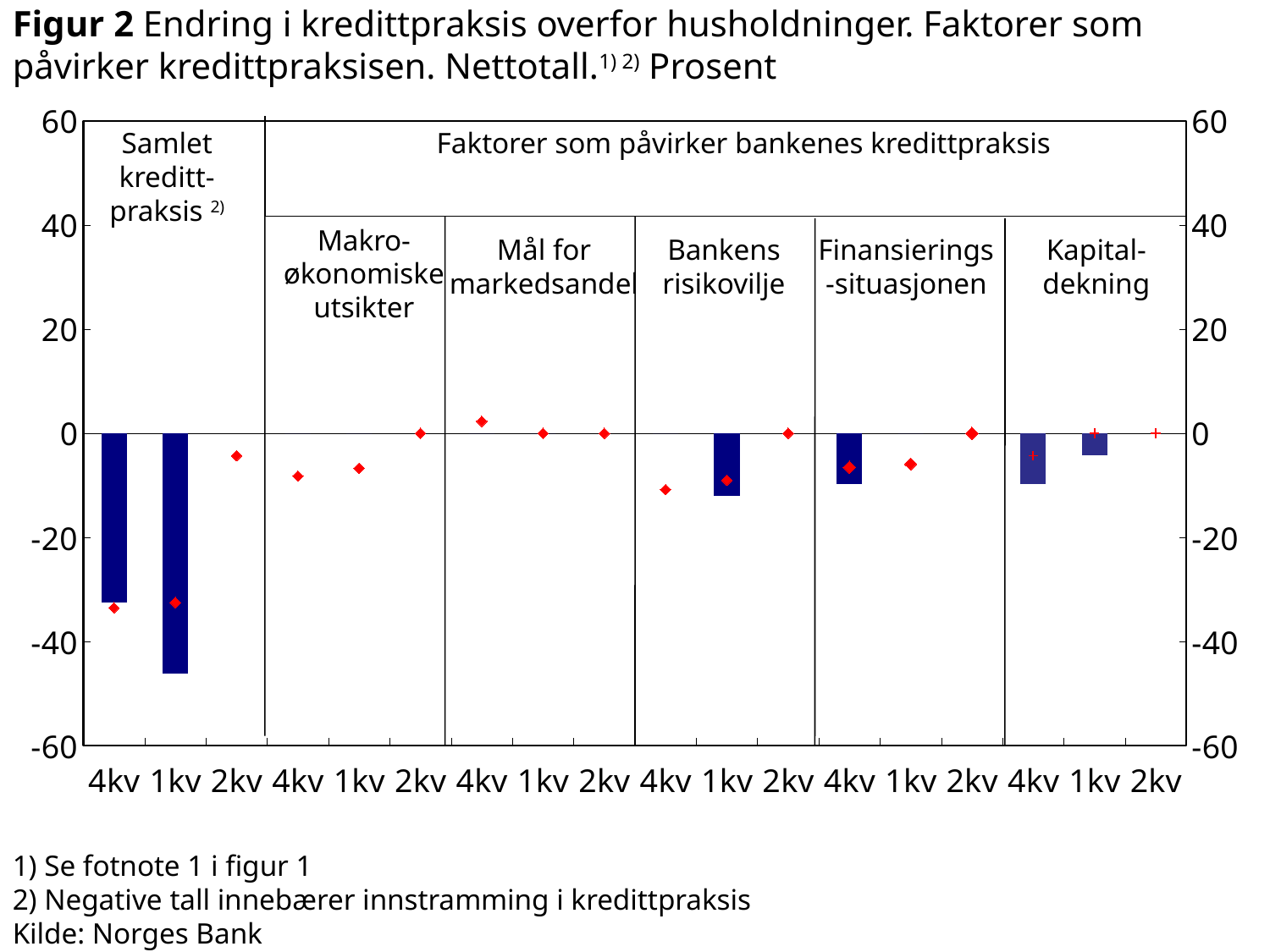
How many quarters (x-axis labels) are shown within each panel of the chart? 3 What is the maximum value shown on the chart's vertical axis? 60 Is the bar for 1kv under 'Bankens risikovilje' greater or less than -20? greater Under 'Samlet kredittpraksis', which bar is lower: 4kv or 1kv? 1kv How many factor panels are shown under 'Faktorer som påvirker bankenes kredittpraksis'? 5 Under 'Kapitaldekning', which bar is lower: 4kv or 1kv? 4kv According to footnote 2, what do negative numbers in the chart indicate? Innstramming i kredittpraksis What kind of chart is shown in Figur 2? bar chart with diamond markers (combination bar and marker chart) Which bar in the chart reaches the lowest value? Samlet kredittpraksis, 1kv Is the bar for 4kv under 'Samlet kredittpraksis' greater or less than -40? greater Is the bar for 1kv under 'Samlet kredittpraksis' greater or less than -40? less